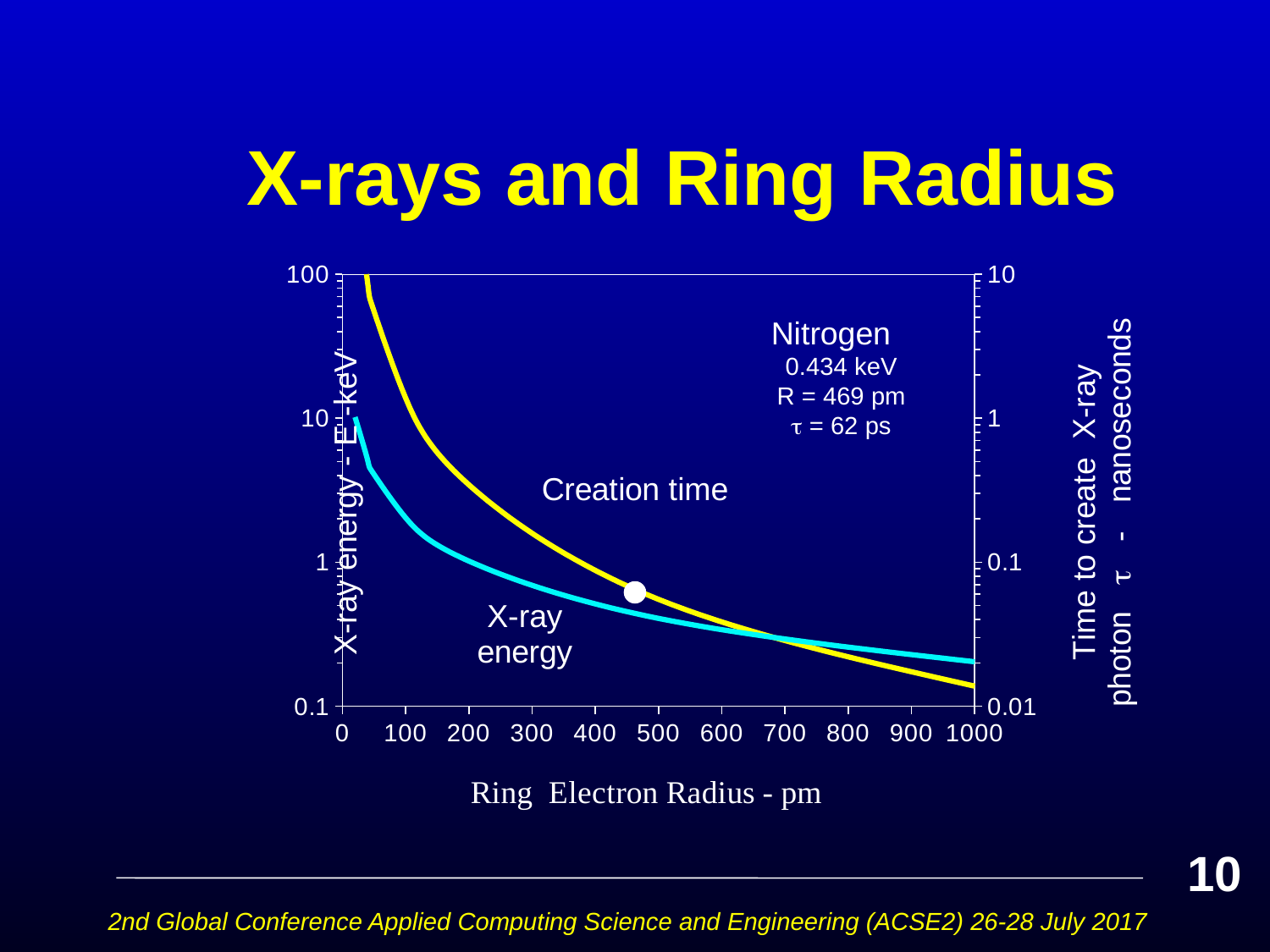
Is the X-ray energy at a radius of 1000 pm greater or less than 1 keV? less How many curves are plotted on the chart? 2 Is the X-ray energy at a radius of 100 pm greater or less than 1 keV? greater What ring radius R is given for Nitrogen in the chart annotation? R = 469 pm What is the title of the slide's chart? X-rays and Ring Radius Is the creation time at a radius of 1000 pm greater or less than 0.1 nanoseconds? less What is the label of the x axis? Ring Electron Radius - pm What kind of chart is shown on the slide? line chart Does the Creation time curve rise or fall as the ring electron radius increases? fall What creation time τ is given for Nitrogen in the chart annotation? τ = 62 ps Does the X-ray energy curve rise or fall as the ring electron radius increases? fall What X-ray energy is given for Nitrogen in the chart annotation? 0.434 keV